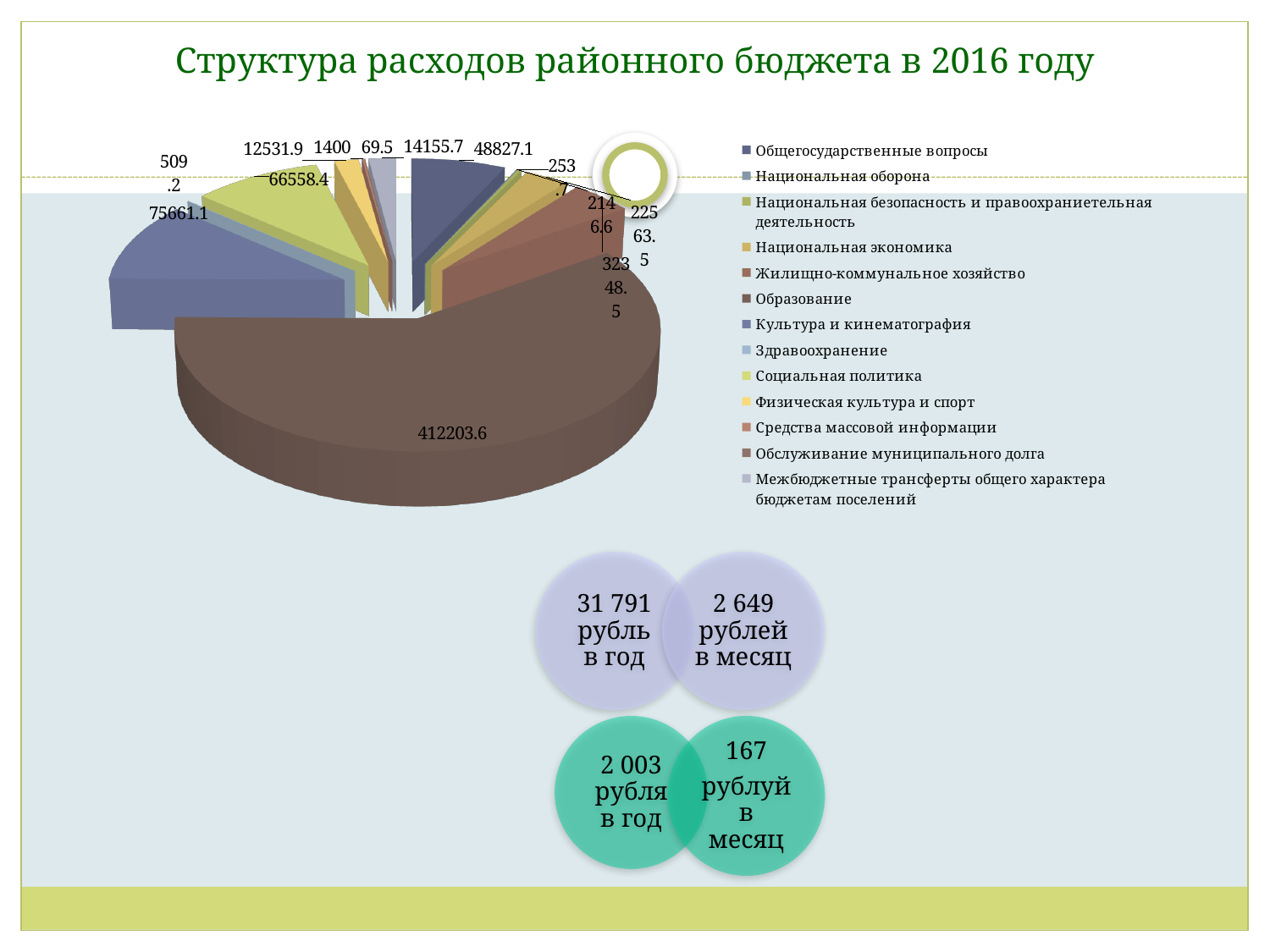
What is the difference between the slice labelled 66558.4 and the slice labelled 12531.9? 54026.5 Which category has the largest slice in the pie chart? Образование What is the title of the chart on the slide? Структура расходов районного бюджета в 2016 году How many slices does the pie chart have? 13 What is the value labelled on the Образование slice? 412203.6 Which legend entry is listed first in the pie chart's legend? Общегосударственные вопросы What is the smallest value labelled on the pie chart? 69.5 Which is larger, the slice labelled 412203.6 or the slice labelled 75661.1? 412203.6 What is the difference between the slice labelled 412203.6 and the slice labelled 75661.1? 336542.5 What kind of chart is shown on the slide? pie chart How many categories does the legend of the pie chart list? 13 What is the largest value labelled on the pie chart? 412203.6